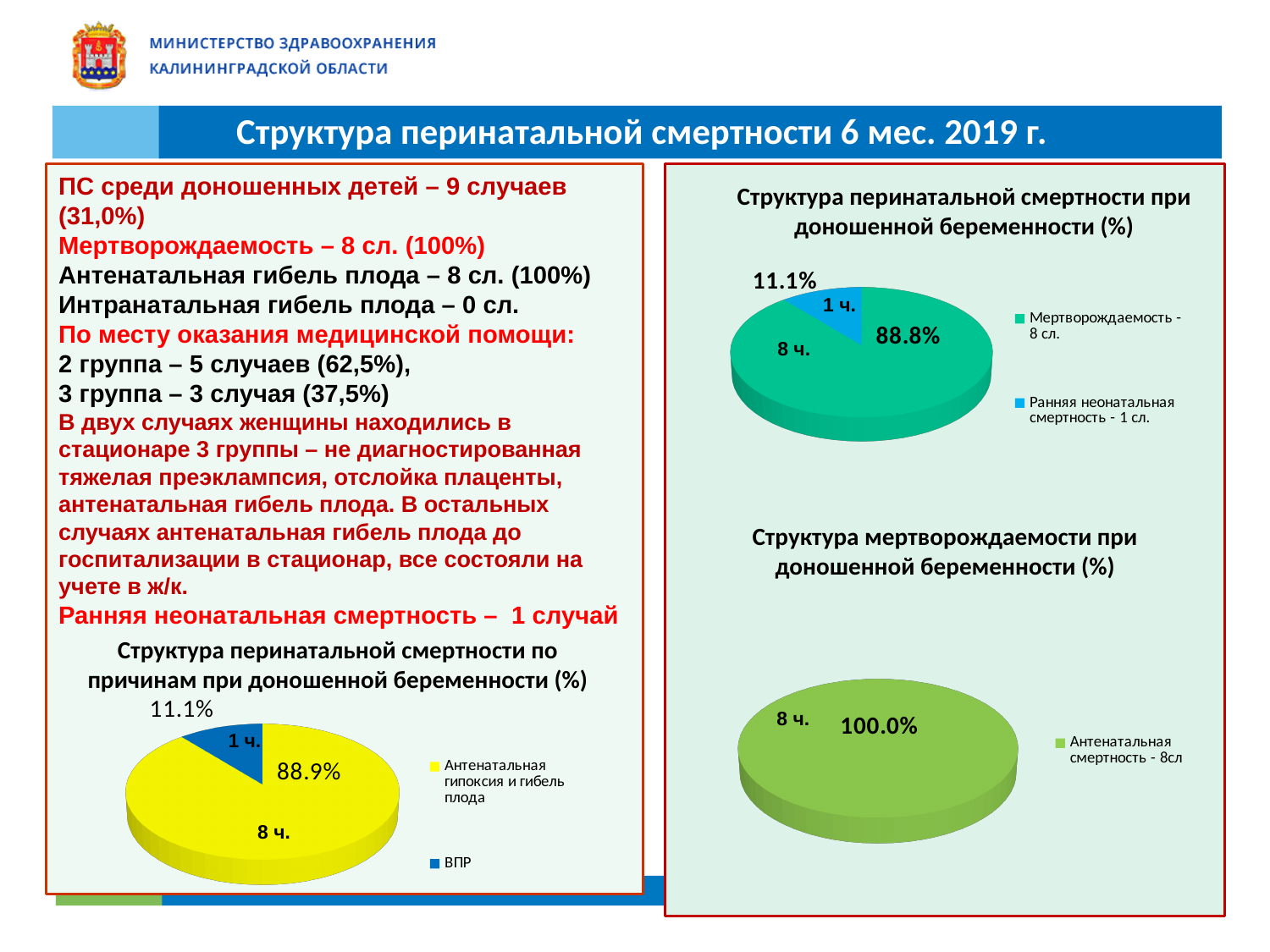
In the chart 'Структура перинатальной смертности по причинам при доношенной беременности (%)', which slice is the smallest? ВПР In the chart 'Структура перинатальной смертности при доношенной беременности (%)', what share is shown for 'Ранняя неонатальная смертность - 1 сл.'? 11.1% How many legend entries does the chart 'Структура перинатальной смертности при доношенной беременности (%)' list? 2 In the chart 'Структура перинатальной смертности по причинам при доношенной беременности (%)', what share is shown for 'ВПР'? 11.1% What type of chart is 'Структура мертворождаемости при доношенной беременности (%)'? Pie chart In the chart 'Структура перинатальной смертности по причинам при доношенной беременности (%)', what is the difference in percentage points between 'Антенатальная гипоксия и гибель плода' and 'ВПР'? 77.8 How many slices does the chart 'Структура мертворождаемости при доношенной беременности (%)' have? 1 How many pie charts are shown on the slide? 3 In the chart 'Структура мертворождаемости при доношенной беременности (%)', what share is shown for 'Антенатальная смертность - 8сл'? 100.0% In the chart 'Структура перинатальной смертности при доношенной беременности (%)', which slice is the largest? Мертворождаемость - 8 сл.